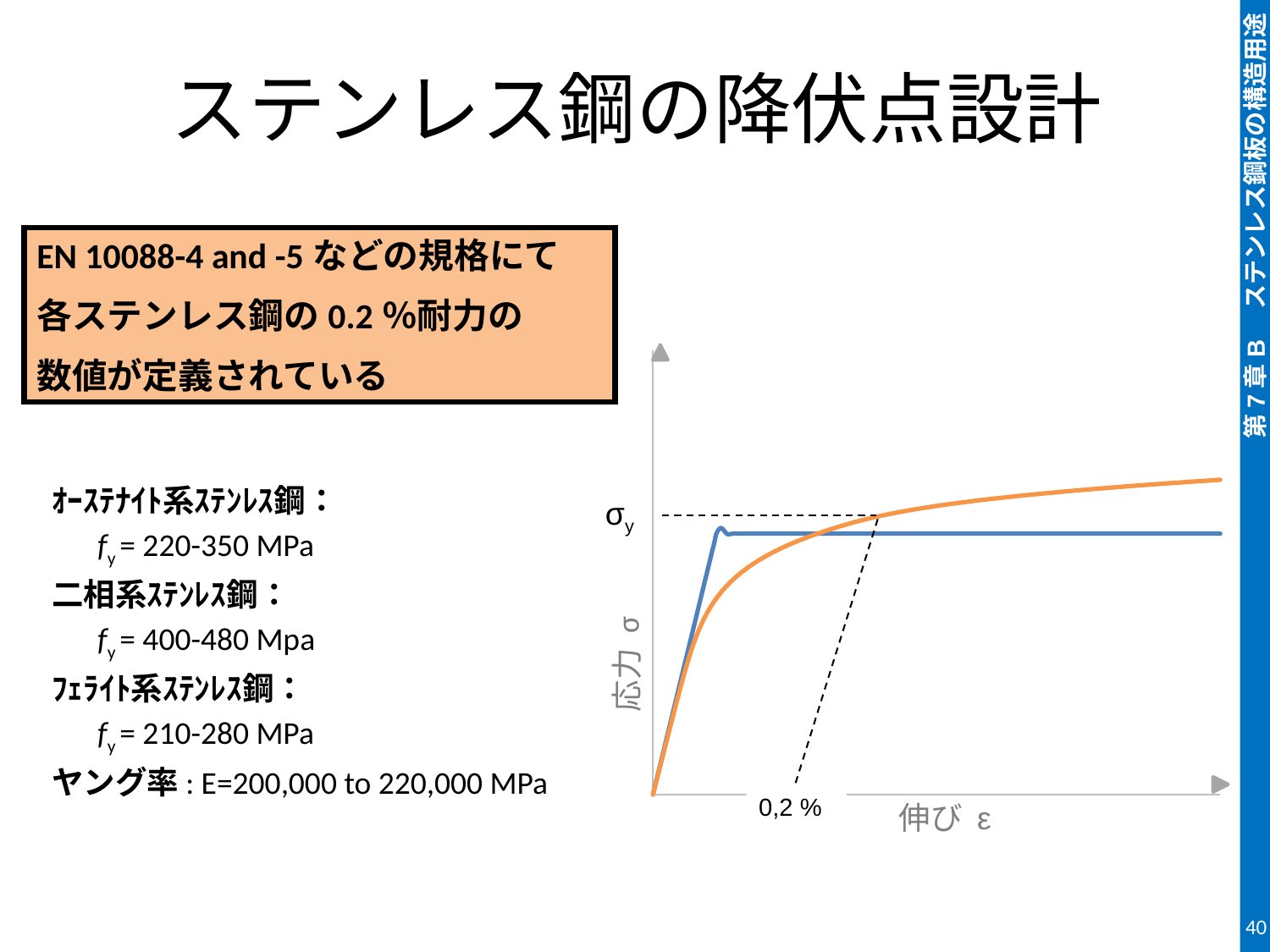
What symbol marks the stress level on the y axis where the dashed horizontal line meets the orange curve? σy At large strain on the right of the chart, which curve is higher, the orange or the blue? orange What is the label on the vertical axis of the chart? 応力 σ After its initial peak, does the blue curve rise, fall, or stay flat as strain increases? stay flat What is the label on the horizontal axis of the chart? 伸び ε Does the orange curve rise or fall as strain increases along the x axis? rise What strain offset value is marked on the x axis by the dashed line? 0,2 % What kind of chart is shown on the right side of the slide? line chart How many curves are plotted on the stress-strain chart? 2